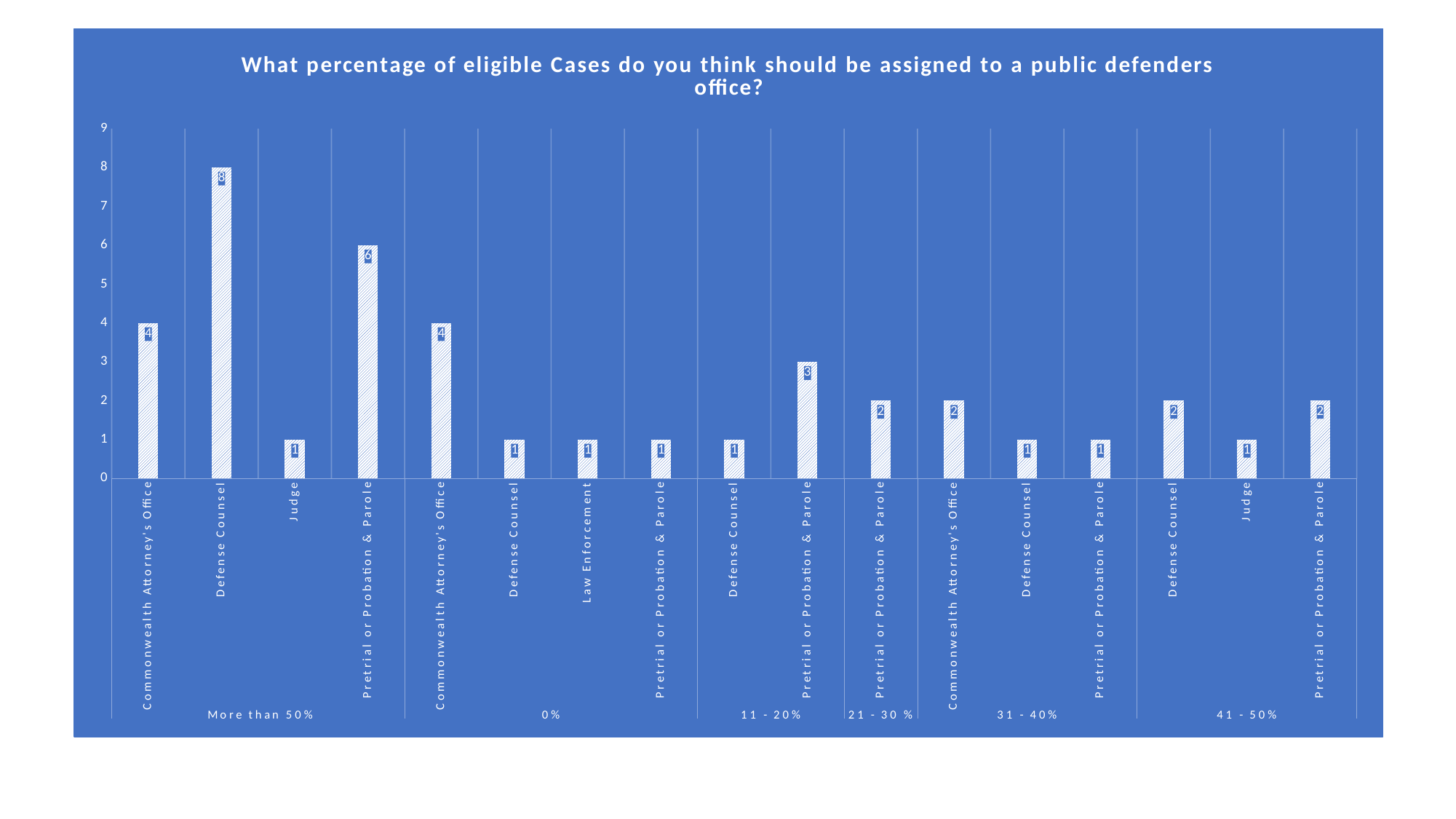
What is the value for Pretrial or Probation & Parole in the '11 - 20%' group? 3 What is the difference between Commonwealth Attorney's Office in the 'More than 50%' group and Commonwealth Attorney's Office in the '31 - 40%' group? 2 What is the difference between Defense Counsel and Pretrial or Probation & Parole in the 'More than 50%' group? 2 Which is larger: Pretrial or Probation & Parole in the 'More than 50%' group or Pretrial or Probation & Parole in the '11 - 20%' group? Pretrial or Probation & Parole in the 'More than 50%' group What is the value for Defense Counsel in the 'More than 50%' group? 8 Which bar has the highest value on the chart? Defense Counsel (More than 50%) What is the title of the chart? What percentage of eligible Cases do you think should be assigned to a public defenders office? How many bars are plotted on the chart in total? 17 What kind of chart is shown on the slide? Bar chart What is the value for Commonwealth Attorney's Office in the '0%' group? 4 What is the value for Judge in the '41 - 50%' group? 1 How many percentage groups are shown along the x axis? 6